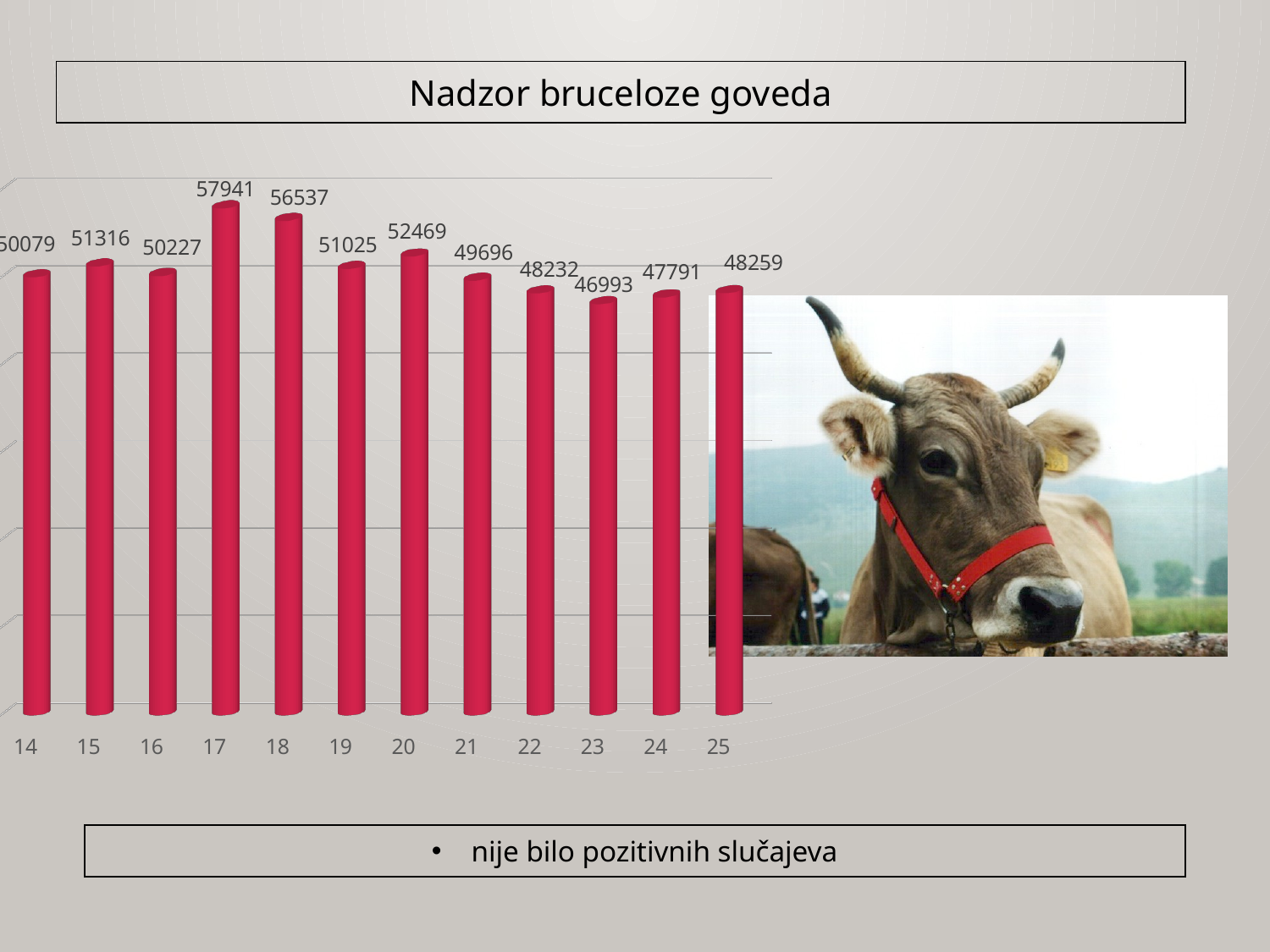
How many categories are shown on the x axis? 12 What is the value for category 17? 57941 What is the value for category 20? 52469 What is the title of the slide above the chart? Nadzor bruceloze goveda What kind of chart is shown on the slide? bar chart Which category has the highest value? 17 What is the value for category 23? 46993 Which category has the lowest value? 23 What is the value for category 25? 48259 What is the difference between the values for categories 17 and 18? 1404 Which is larger, the value for category 19 or the value for category 20? 20 What is the difference between the values for categories 24 and 23? 798